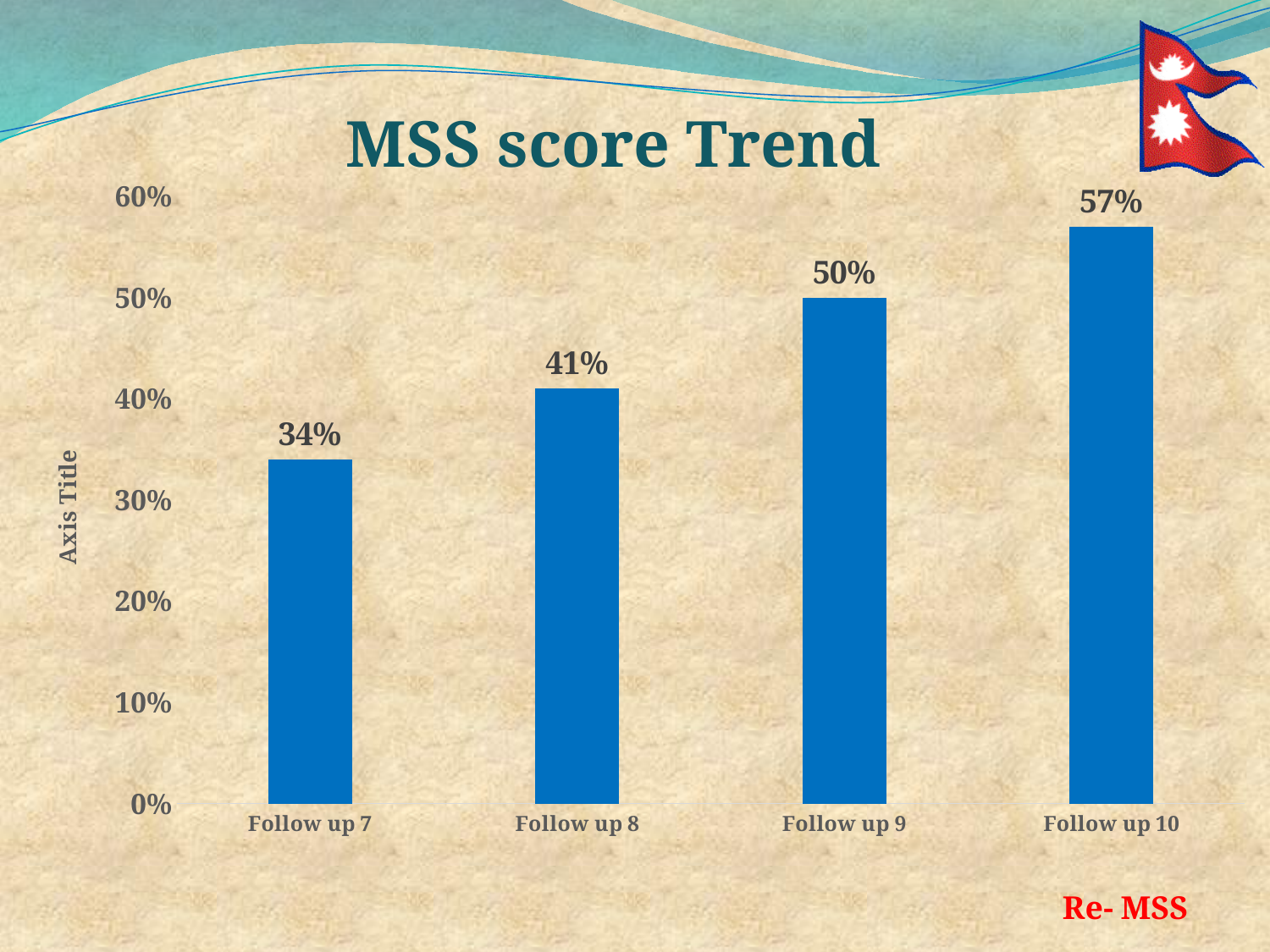
What kind of chart is shown on the slide? Bar chart Do the MSS scores rise or fall from Follow up 7 to Follow up 10? Rise What is the MSS score for Follow up 7? 34% How many follow ups are shown on the chart? 4 What is the difference between the MSS scores for Follow up 10 and Follow up 7? 23% Which is larger, the MSS score for Follow up 8 or for Follow up 9? Follow up 9 What is the difference between the MSS scores for Follow up 8 and Follow up 7? 7% Is the MSS score for Follow up 8 greater or less than 40%? greater What is the MSS score for Follow up 10? 57% Which follow up has the lowest MSS score? Follow up 7 What is the MSS score for Follow up 9? 50% Which follow up has the highest MSS score? Follow up 10